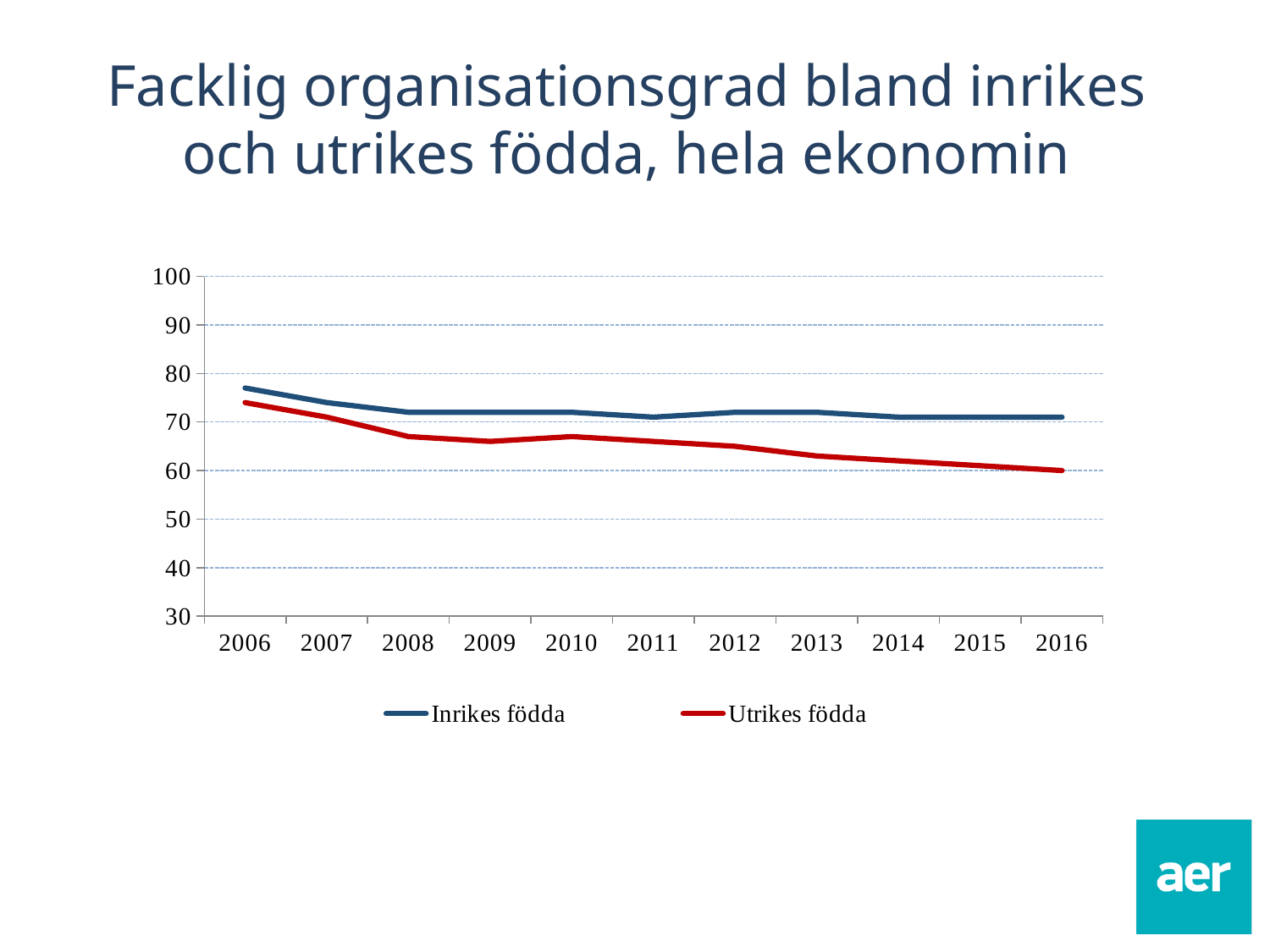
Which series is drawn in red? Utrikes födda Is the value for Utrikes födda in 2016 greater or less than 70? less How many years are shown on the x axis? 11 What are the two series named in the legend? Inrikes födda and Utrikes födda Is the value for Utrikes födda in 2008 greater or less than 70? less What kind of chart is shown on the slide? Line chart Which series has the higher value in 2016, Inrikes födda or Utrikes födda? Inrikes födda In which year is the value for Utrikes födda highest? 2006 Is the value for Inrikes födda in 2006 greater or less than 70? greater How many series does the legend list? 2 Does the Utrikes födda line rise or fall from 2006 to 2016? Fall In which year is the value for Utrikes födda lowest? 2016